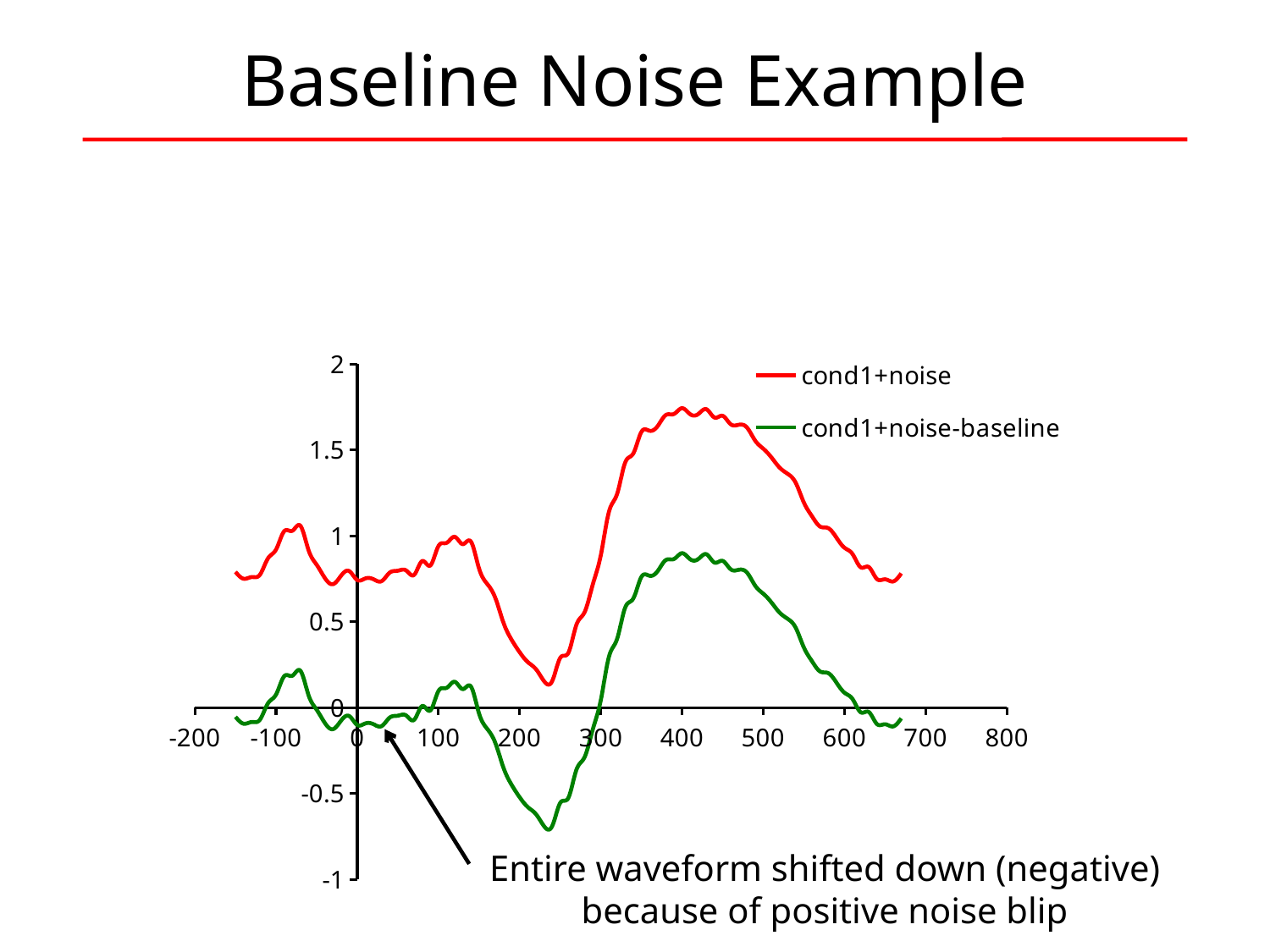
Is the lowest value of the cond1+noise-baseline series, near x = 230, greater or less than -0.5? less Which series reaches the highest value on the chart? cond1+noise Is the value of the cond1+noise series at its dip near x = 230 greater or less than 0.5? less Is the value of the cond1+noise series at x = 0 greater or less than 0.5? greater Which series is drawn in green? cond1+noise-baseline How many series does the legend list? 2 What is the title of the slide containing the chart? Baseline Noise Example What kind of chart is shown on the slide? line chart Which series reaches the lowest value on the chart? cond1+noise-baseline At x = 400, which series has the higher value, cond1+noise or cond1+noise-baseline? cond1+noise